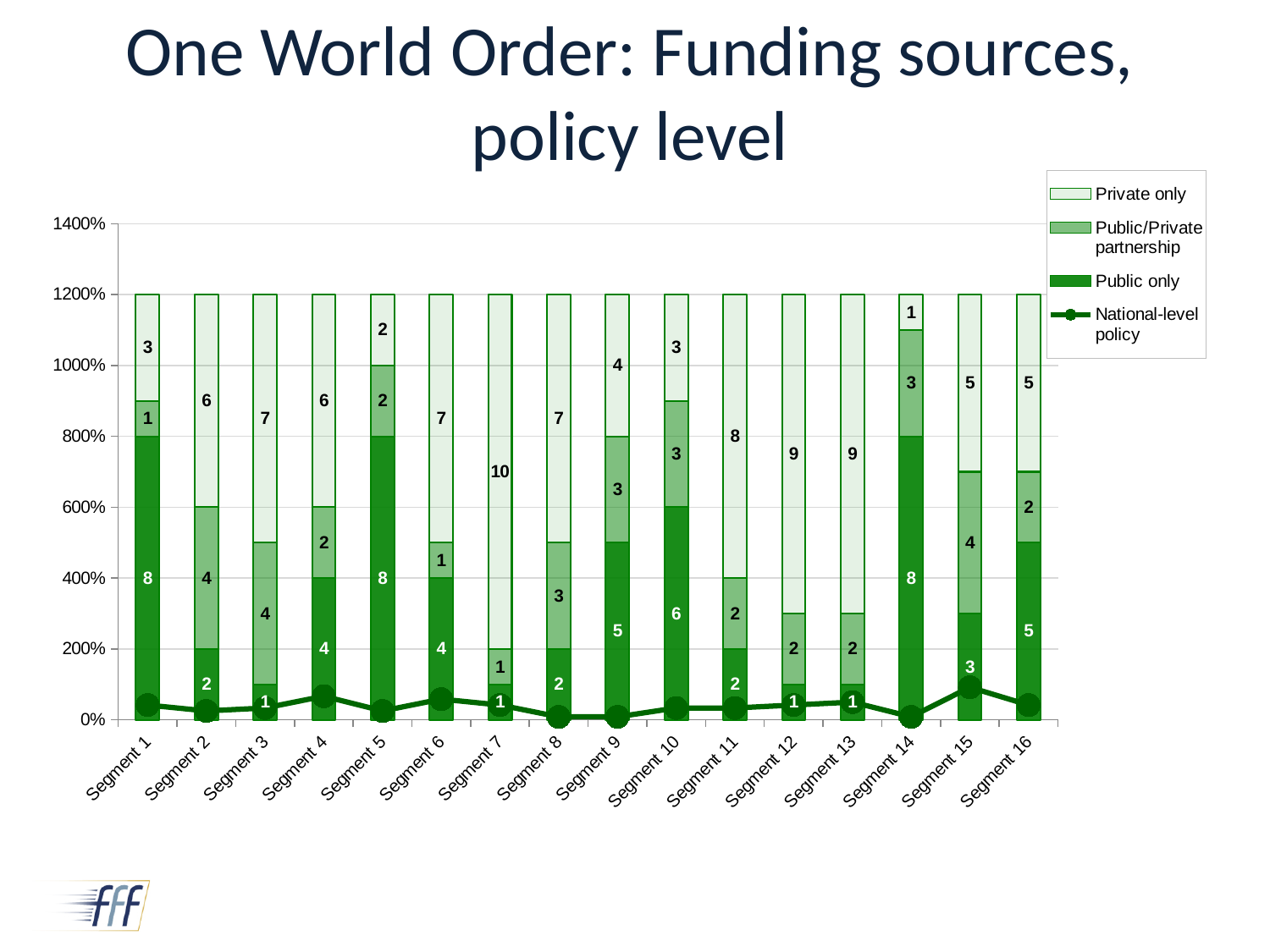
How many entries does the legend list? 4 Which segment has the lowest Private only value? Segment 14 Which segment has the highest Private only value? Segment 7 What is the total of the three stacked values for Segment 10? 12 What is the Public only value for Segment 5? 8 For Segment 12, what is the difference between the Private only value and the Public only value? 8 Which has the larger Public only value, Segment 1 or Segment 2? Segment 1 What is the Private only value for Segment 7? 10 How many segments are shown along the x axis? 16 What kind of chart is shown on the slide? Stacked bar chart (with a line overlay) Which legend entry is represented by the line with markers? National-level policy What is the Public/Private partnership value for Segment 15? 4